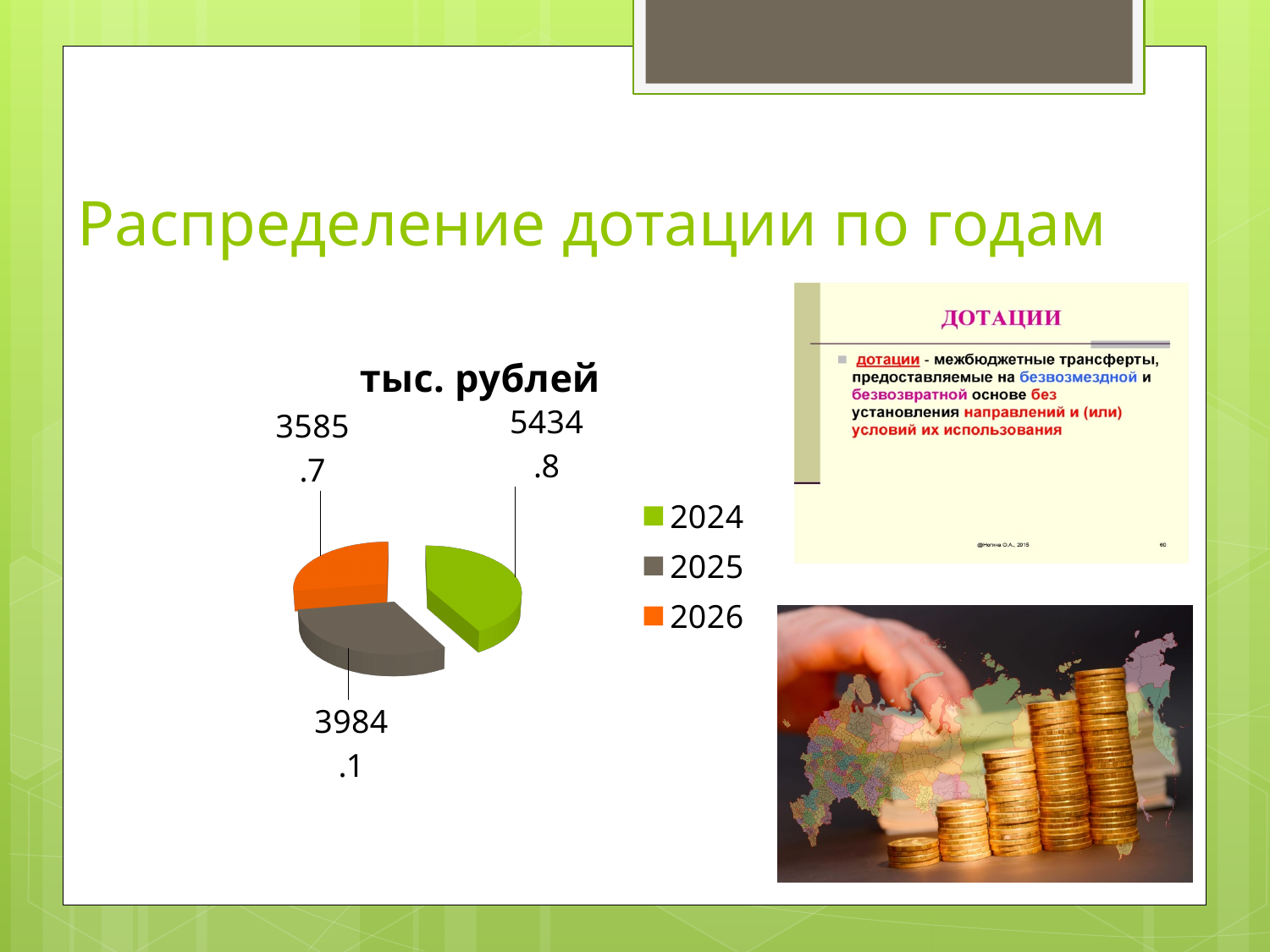
Which year has the smallest slice in the pie chart? 2026 How many slices does the pie chart have? 3 How many entries does the chart legend list? 3 What kind of chart is shown on the slide? Pie chart What is the value for 2024 in the pie chart? 5434.8 What is the difference between the values for 2025 and 2026? 398.4 What is the value for 2025 in the pie chart? 3984.1 What is the value for 2026 in the pie chart? 3585.7 What is the title of the chart? тыс. рублей Which is larger, the value for 2025 or the value for 2026? 2025 What is the difference between the values for 2024 and 2025? 1450.7 Which year has the largest slice in the pie chart? 2024